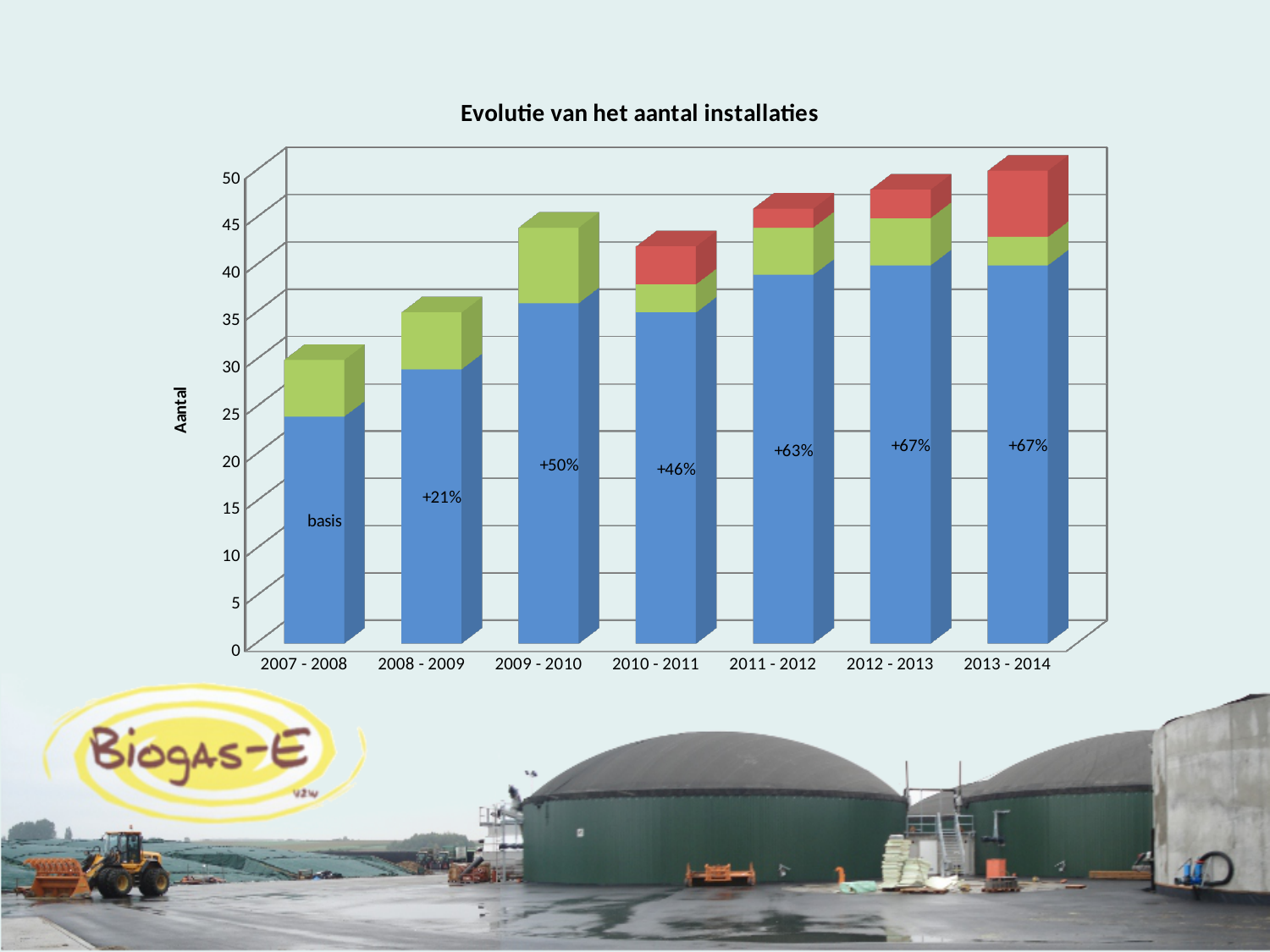
Which period has the tallest bar in the chart? 2013 - 2014 What is the title of the chart? Evolutie van het aantal installaties Which period has the shortest bar in the chart? 2007 - 2008 Is the total height of the bar for 2007 - 2008 greater or less than 20? greater What percentage label is printed on the bar for 2011 - 2012? +63% What percentage label is printed on the bar for 2009 - 2010? +50% Is the blue segment of the bar for 2007 - 2008 greater or less than 30? less What label is printed on the bar for 2007 - 2008? basis How many periods (categories) are shown on the x axis of the chart? 7 What is the label on the vertical axis of the chart? Aantal What kind of chart is shown on the slide? Stacked bar chart What percentage label is printed on the bar for 2008 - 2009? +21%